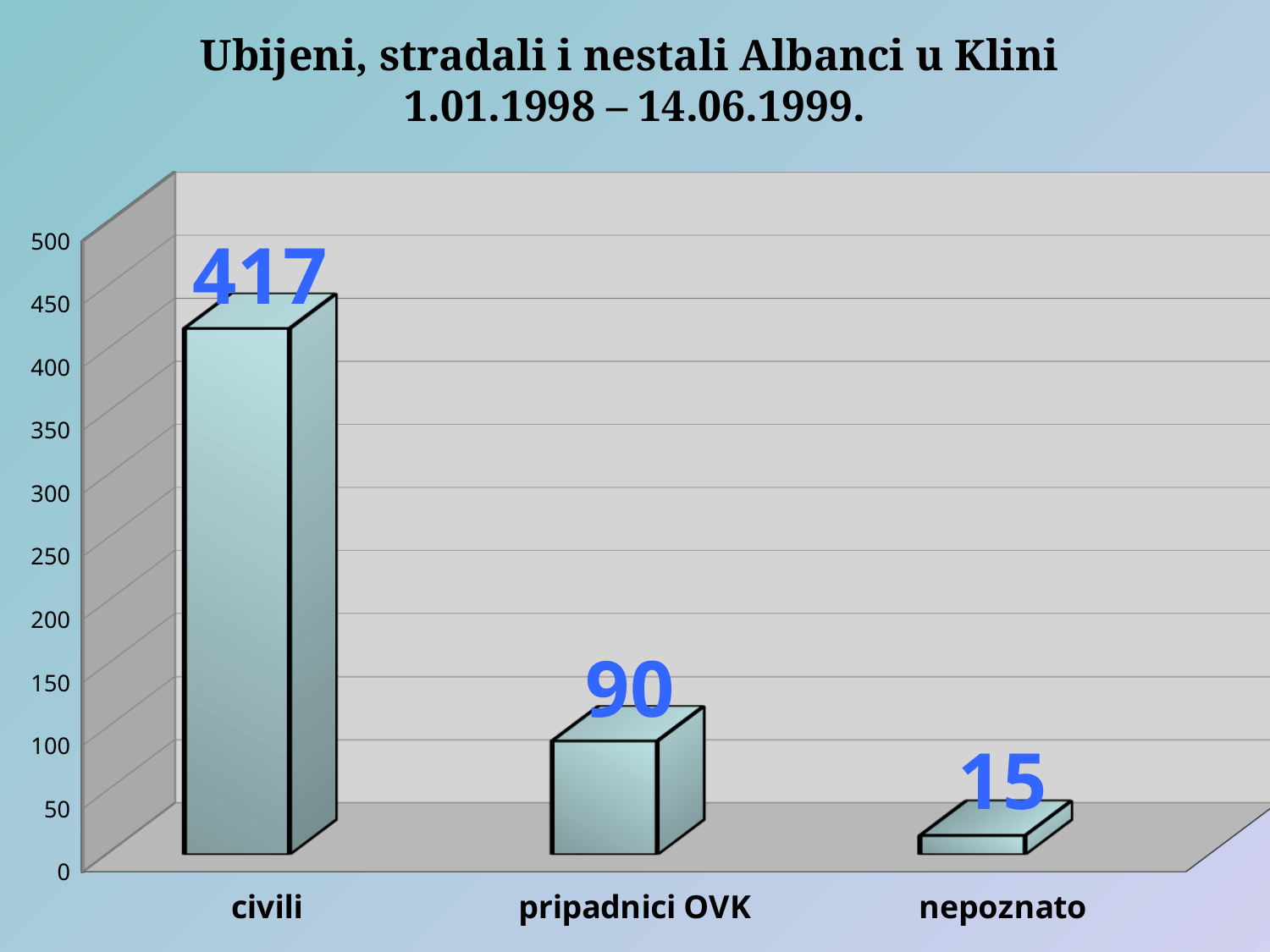
What is the difference between the values for pripadnici OVK and nepoznato? 75 How many categories are shown on the x axis? 3 Which category has the lowest value? nepoznato Which category has the highest value? civili What is the value for pripadnici OVK? 90 Which is larger, the value for pripadnici OVK or the value for nepoznato? pripadnici OVK What is the difference between the values for civili and pripadnici OVK? 327 What is the value for nepoznato? 15 What kind of chart is shown on the slide? bar chart Is the value for civili greater or less than 400? greater What is the title of the chart? Ubijeni, stradali i nestali Albanci u Klini 1.01.1998 – 14.06.1999. What is the value for civili? 417